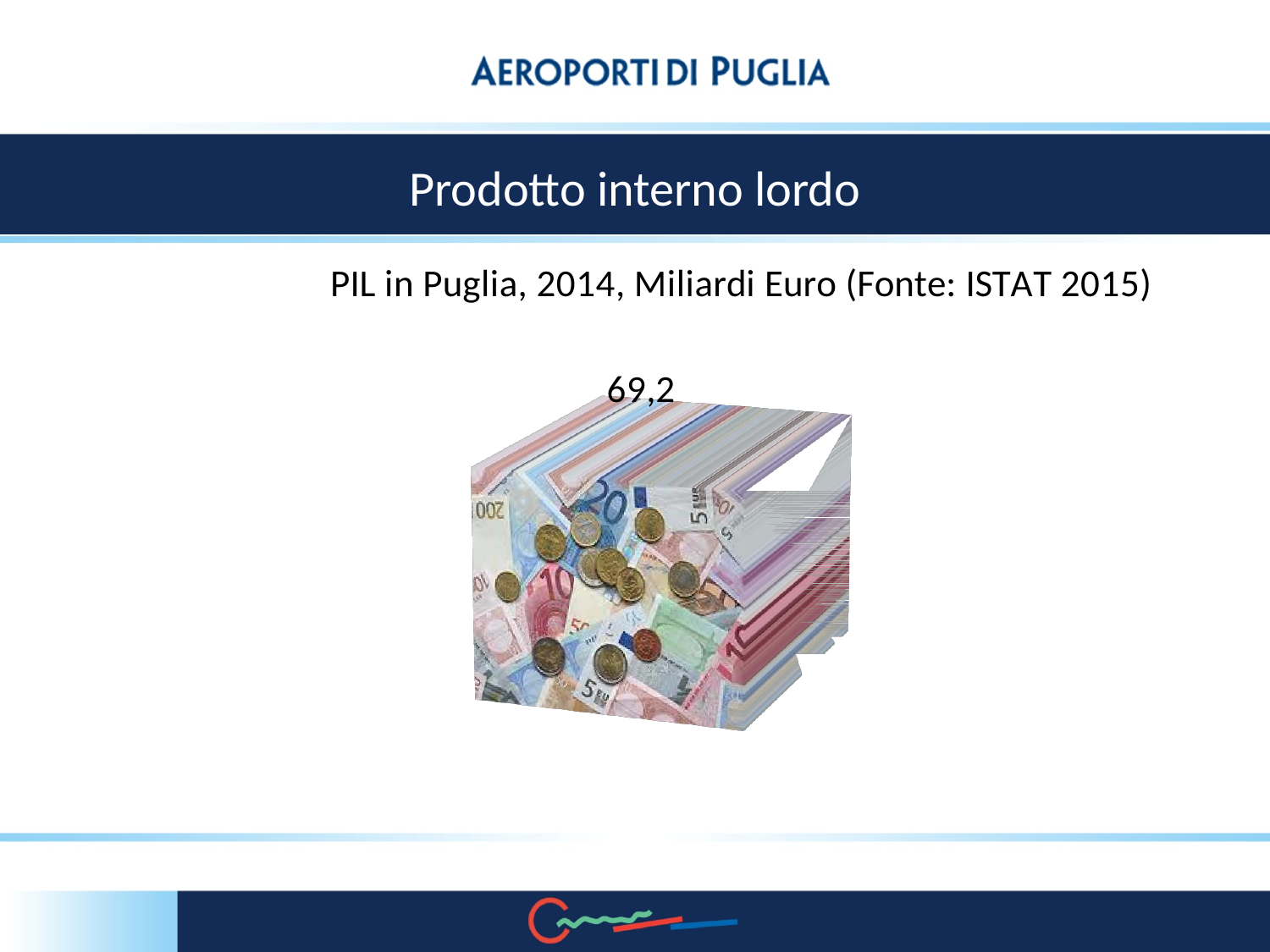
What kind of chart is shown on the slide? bar chart What is the title of the chart? PIL in Puglia, 2014, Miliardi Euro (Fonte: ISTAT 2015) What image is used to fill the bar in the chart? Euro banknotes and coins What value is shown by the data label on the bar in the chart? 69,2 How many bars does the chart contain? 1